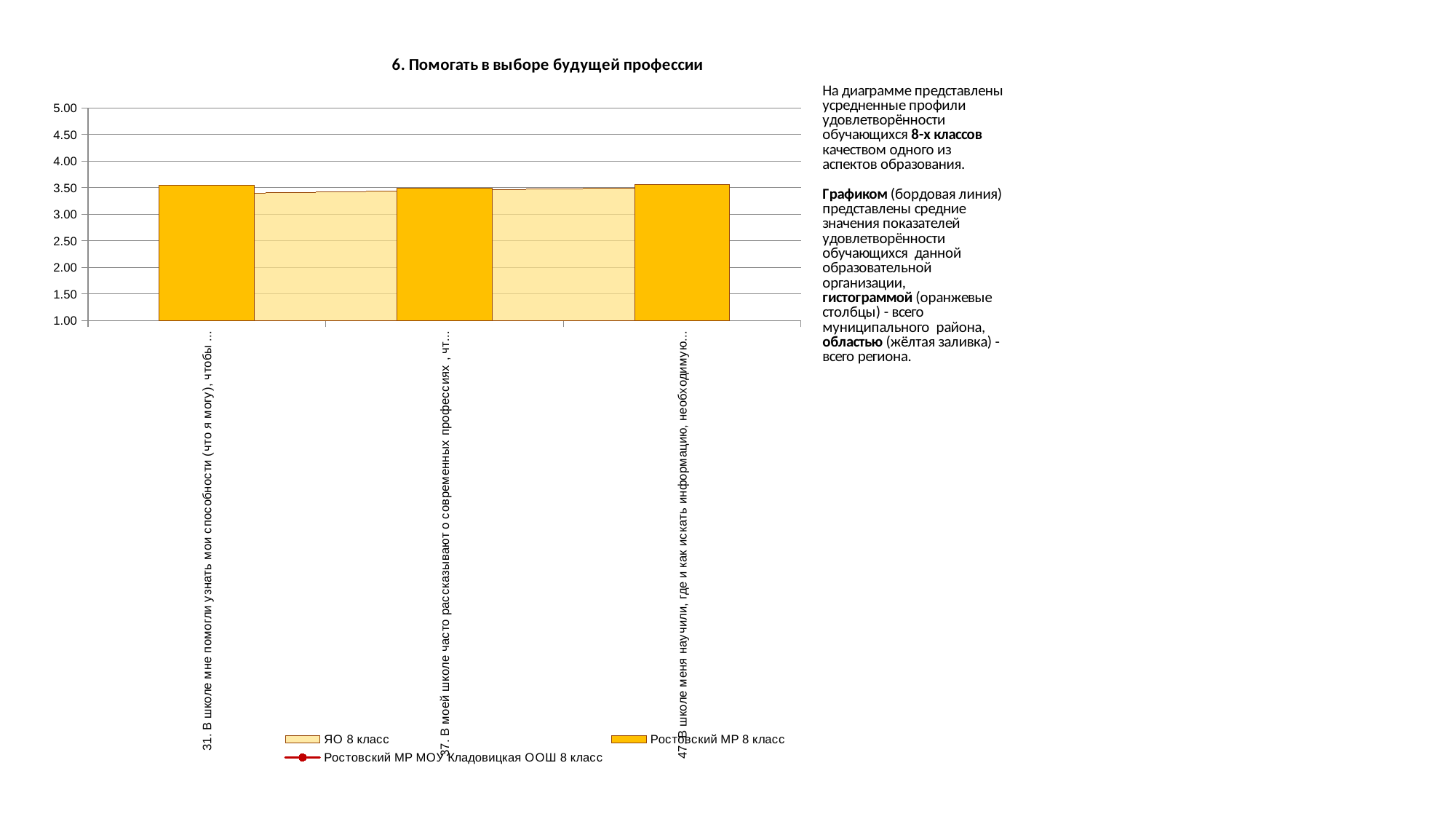
Is the value for 'Ростовский МР 8 класс' in category 47 greater or less than 4.00? less Is the value for 'ЯО 8 класс' in category 37 greater or less than 3.00? greater In category 31, which is larger: the value for 'Ростовский МР 8 класс' or for 'ЯО 8 класс'? Ростовский МР 8 класс What kind of chart is used for the 'Ростовский МР 8 класс' series? bar chart Is the value for 'ЯО 8 класс' in category 47 greater or less than 2.50? greater What colour represents the 'Ростовский МР 8 класс' series? orange How many categories are shown on the x axis? 3 What is the title of the chart? 6. Помогать в выборе будущей профессии How many series does the legend list? 3 What is the highest value shown on the y axis? 5.00